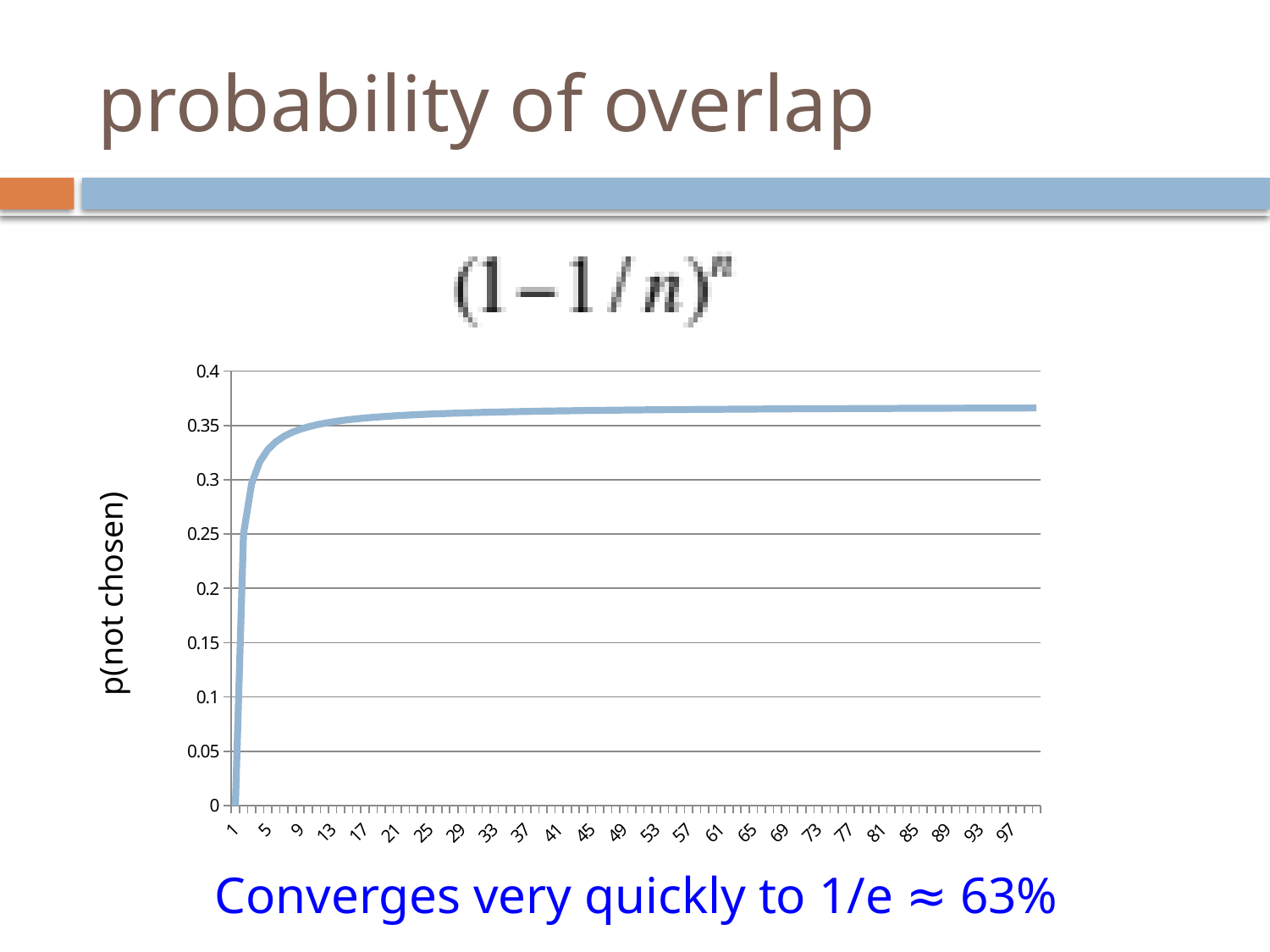
Which has the larger plotted value, n = 5 or n = 49? n = 49 What is the plotted value at n = 1? 0 Do the plotted values rise or fall as n increases along the x axis? rise What is the highest value shown on the y axis? 0.4 Is the value for n = 97 greater or less than 0.4? less What is the label on the y axis of the chart? p(not chosen) How many tick labels are shown on the x axis? 25 Is the value for n = 97 greater or less than 0.35? greater What formula is shown above the chart? (1-1/n)^n What kind of chart is shown on the slide? line chart Is the value for n = 9 greater or less than 0.3? greater Which has the larger plotted value, n = 1 or n = 97? n = 97